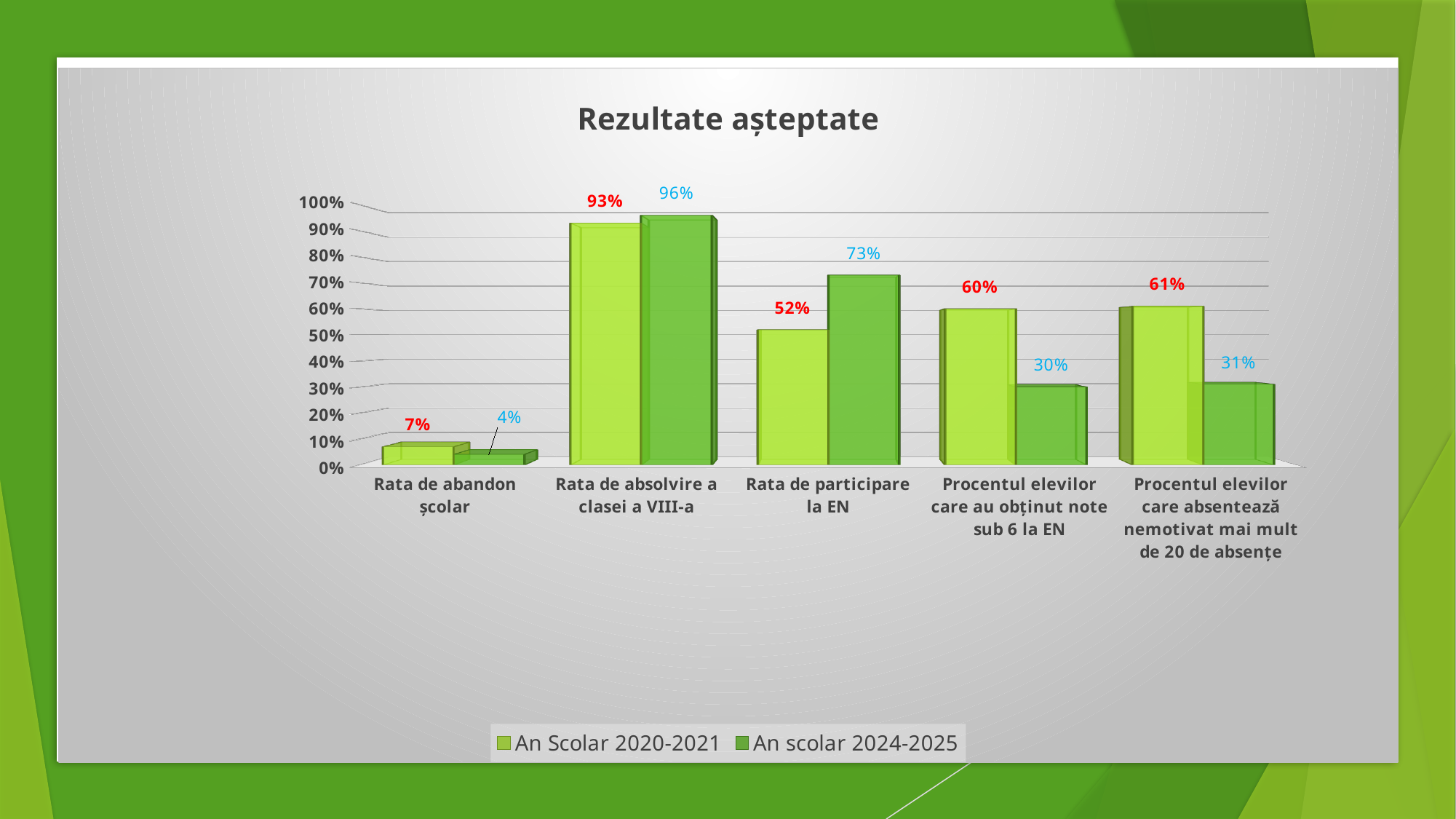
How many categories are shown on the x axis? 5 What is the title of the chart? Rezultate așteptate What is the value for 'Rata de participare la EN' in the 'An Scolar 2020-2021' series? 52% How many series does the legend list? 2 What kind of chart is shown on the slide? Bar chart Which category has the highest value in the 'An scolar 2024-2025' series? Rata de absolvire a clasei a VIII-a Which category has the lowest value in the 'An Scolar 2020-2021' series? Rata de abandon școlar What is the value for 'Rata de absolvire a clasei a VIII-a' in the 'An scolar 2024-2025' series? 96% What is the value for 'Procentul elevilor care absentează nemotivat mai mult de 20 de absențe' in the 'An scolar 2024-2025' series? 31% What is the difference between the 'An Scolar 2020-2021' and 'An scolar 2024-2025' values for 'Procentul elevilor care au obținut note sub 6 la EN'? 30% For 'Rata de participare la EN', which series has the larger value? An scolar 2024-2025 What is the value for 'Rata de abandon școlar' in the 'An Scolar 2020-2021' series? 7%